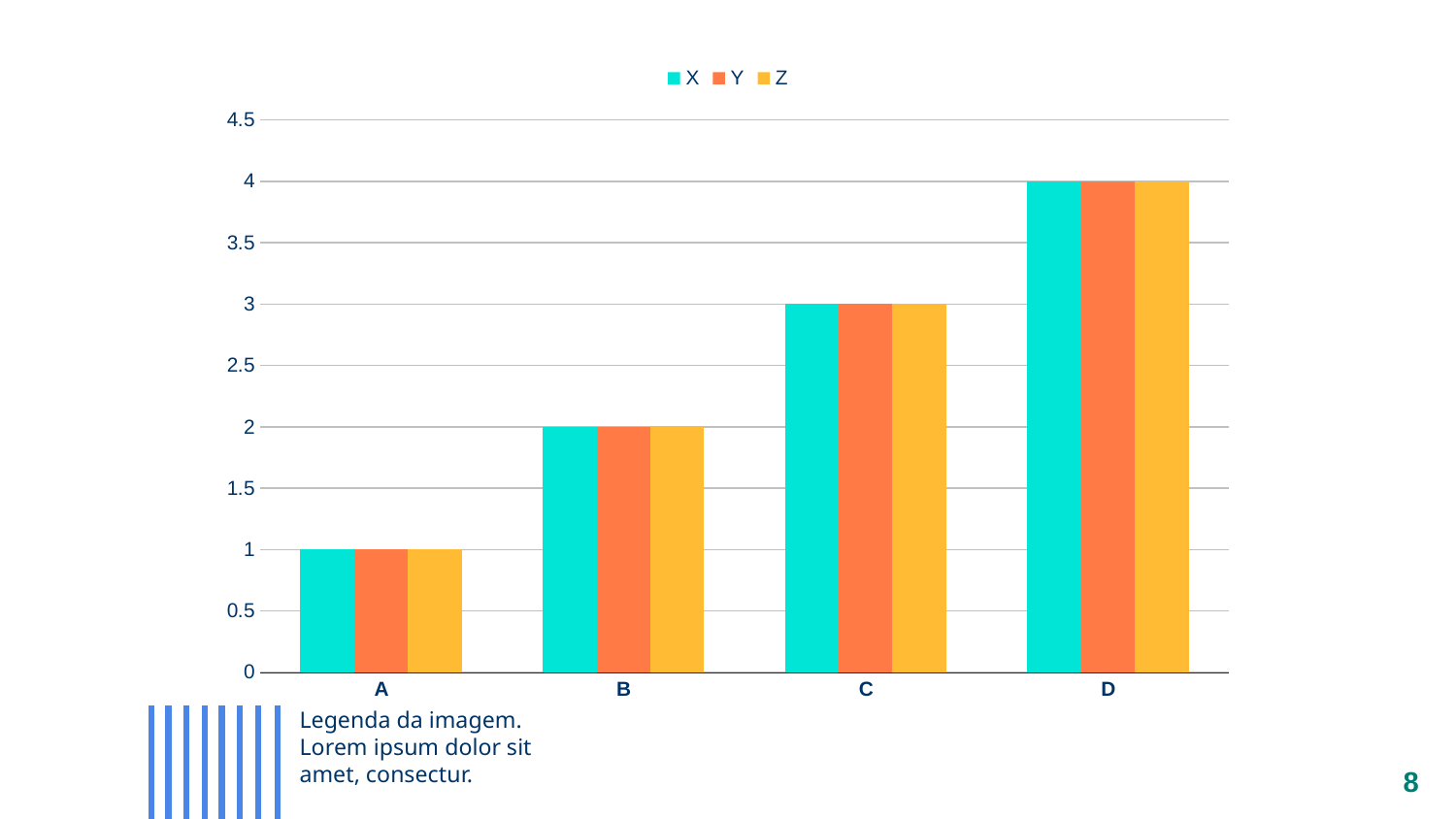
Which is larger: the value of series X for category C or for category B? C What colour are the bars for series Y? orange Do the values for series Z rise or fall from category A to category D? rise What is the value of series Z for category D? 4 How many categories are shown on the x axis? 4 What kind of chart is shown on the slide? bar chart Which category has the lowest value for series Z? A What is the value of series Y for category C? 3 How many series does the legend list? 3 Which category has the highest value for series X? D What is the value of series X for category A? 1 What is the difference between the value of series Y for category D and for category B? 2